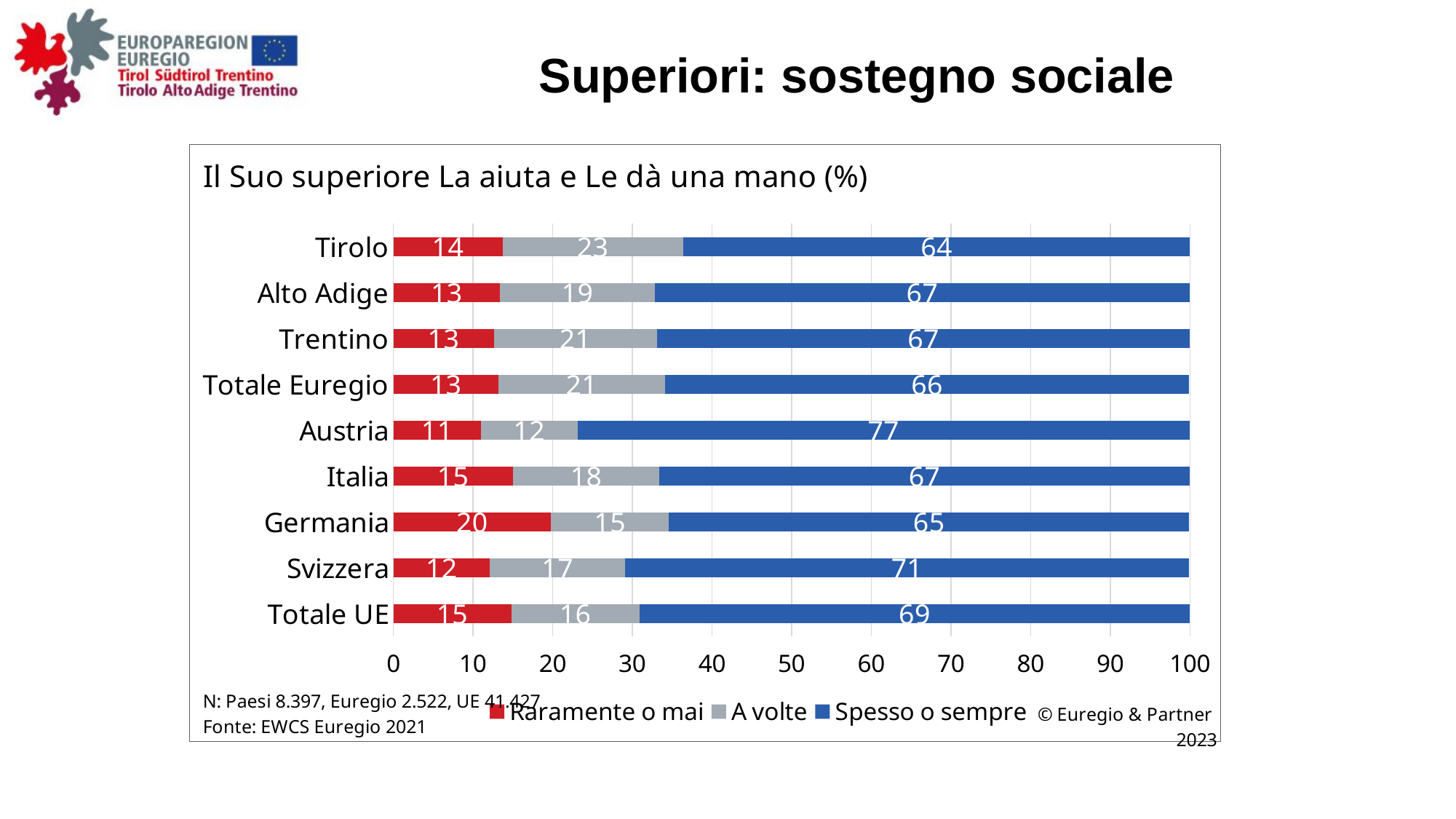
What is the value of 'Spesso o sempre' for Austria? 77 Which is larger: the 'A volte' value for Alto Adige or for Trentino? Trentino Which category has the lowest value for 'A volte'? Austria What is the value of 'A volte' for Tirolo? 23 What kind of chart is shown? Stacked bar chart How many series does the legend list? 3 What is the title of the chart? Il Suo superiore La aiuta e Le dà una mano (%) What is the difference between the 'Spesso o sempre' values for Austria and Tirolo? 13 Which category has the highest value for 'Spesso o sempre'? Austria Which category has the highest value for 'Raramente o mai'? Germania How many categories are shown on the y axis? 9 What is the value of 'Raramente o mai' for Germania? 20